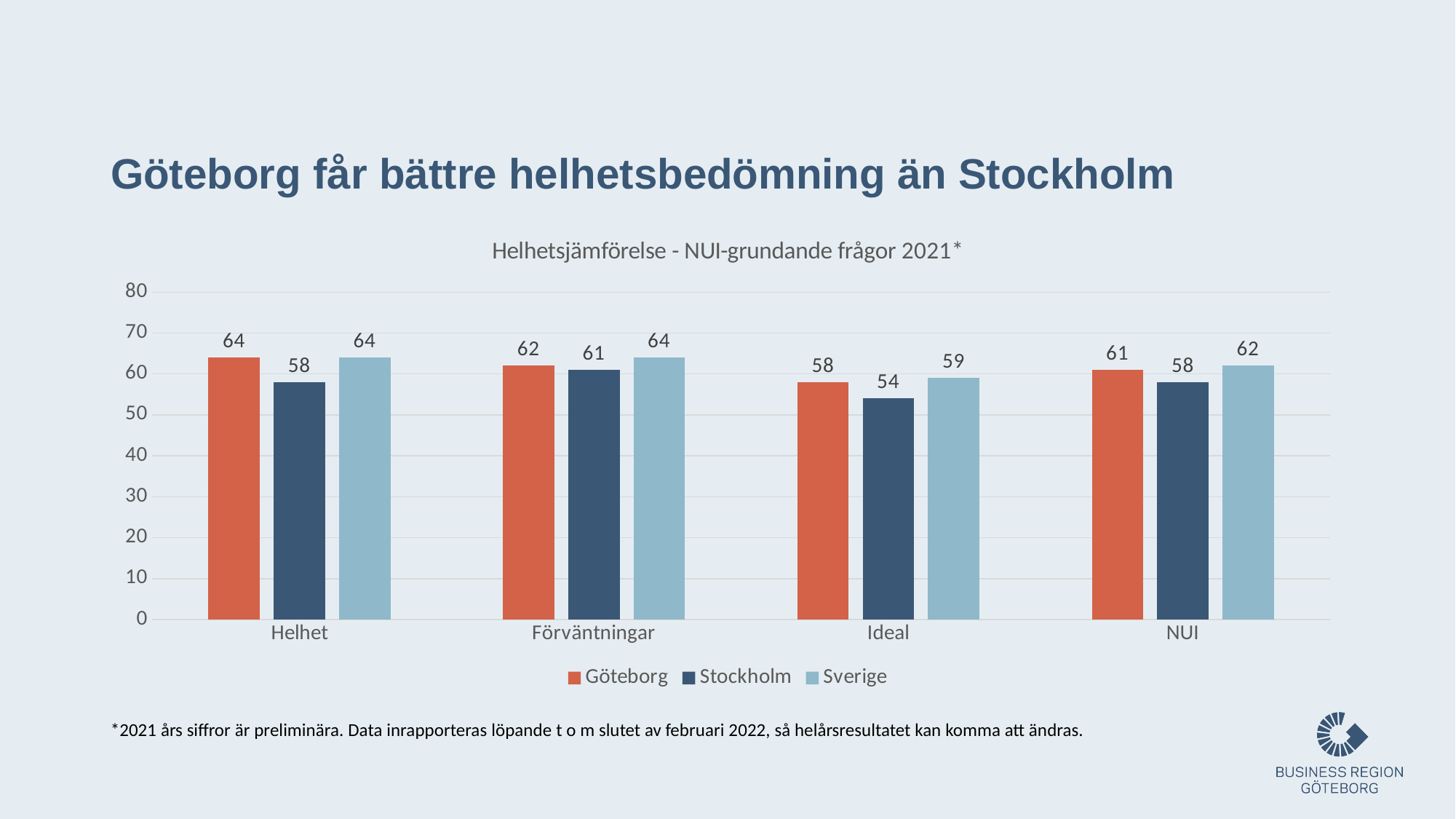
What is the value for Sverige in the Förväntningar category? 64 What kind of chart is shown on the slide? Bar chart Which is larger in the NUI category, Göteborg or Stockholm? Göteborg What is the value for Stockholm in the Ideal category? 54 What is the difference between Sverige and Stockholm in the Ideal category? 5 What is the value for Göteborg in the NUI category? 61 How many categories are shown on the x axis? 4 Which category has the highest value for Göteborg? Helhet What is the difference between Göteborg and Stockholm in the Helhet category? 6 Which category has the lowest value for Stockholm? Ideal How many series does the legend list? 3 What is the value for Göteborg in the Helhet category? 64